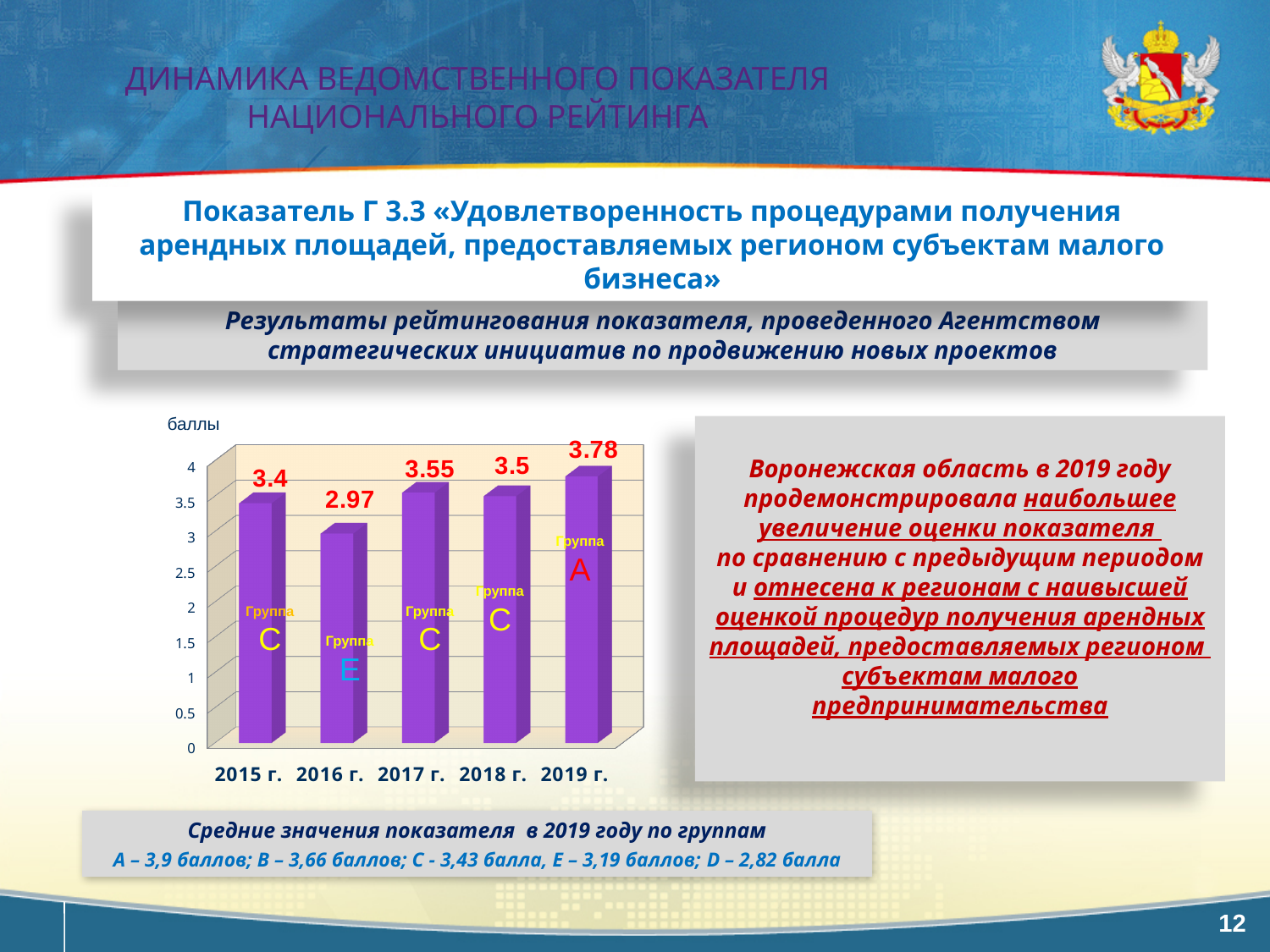
What is the value for 2019 г.? 3.78 What is the value for 2016 г.? 2.97 Which year has the highest value? 2019 г. What is the value for 2015 г.? 3.4 How many years are shown on the x axis? 5 What is the difference between the values for 2017 г. and 2016 г.? 0.58 Which group label is shown on the bar for 2019 г.? Группа A Is the value for 2016 г. greater or less than 3? less What kind of chart is shown on the slide? bar chart Which is larger, the value for 2017 г. or the value for 2015 г.? 2017 г. Which year has the lowest value? 2016 г. What is the difference between the values for 2019 г. and 2018 г.? 0.28